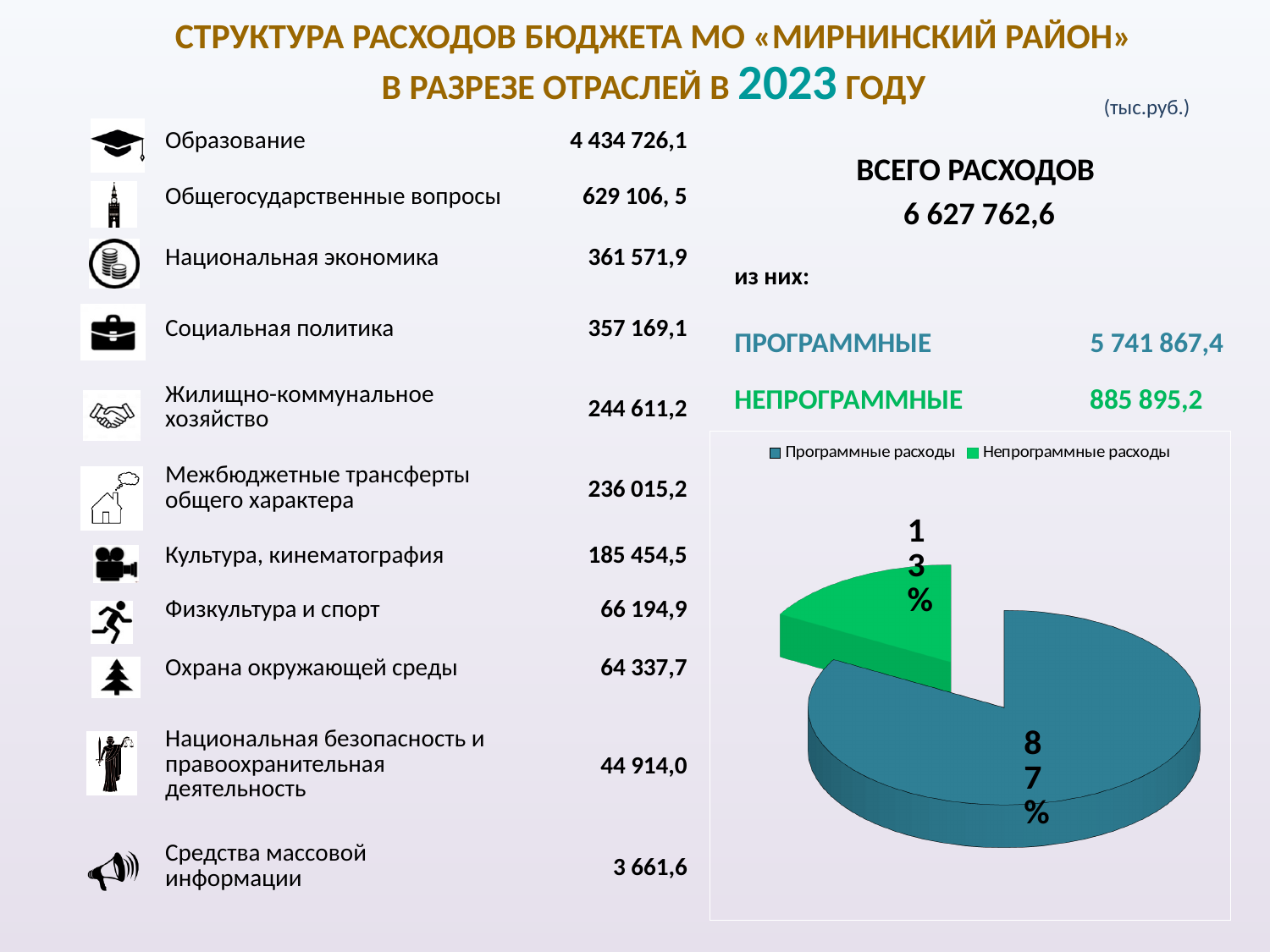
How many entries does the pie chart's legend list? 2 What kind of chart is shown on the slide? pie chart By how many percentage points does the Программные расходы share exceed the Непрограммные расходы share? 74 Which is larger in the pie chart: Программные расходы or Непрограммные расходы? Программные расходы What colour is the Программные расходы slice in the pie chart? teal blue Which slice of the pie chart is the largest? Программные расходы What colour is the Непрограммные расходы slice in the pie chart? green Which slice of the pie chart is the smallest? Непрограммные расходы What share of the pie does Программные расходы take? 87% How many slices does the pie chart have? 2 What share of the pie does Непрограммные расходы take? 13%